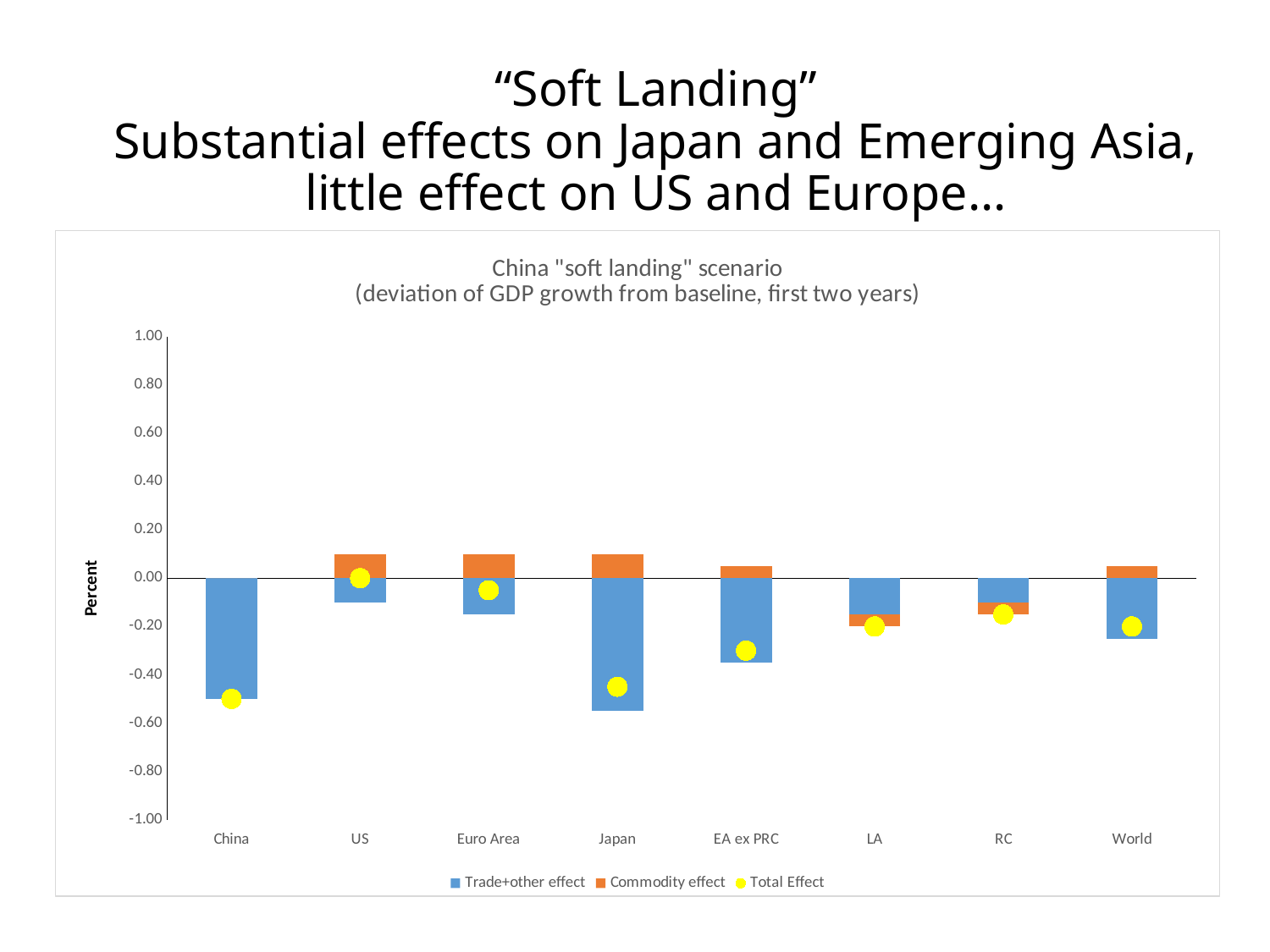
How many series does the chart's legend list? 3 Is the Total Effect value for EA ex PRC greater or less than -0.20? less Is the Commodity effect value for Japan greater or less than 0.00? greater What kind of chart is shown on the slide? bar chart How many countries or regions are shown on the x axis of the chart? 8 Which series in the chart is shown with yellow circle markers? Total Effect What is the title of the chart? China "soft landing" scenario (deviation of GDP growth from baseline, first two years) Is the Trade+other effect value for Japan greater or less than -0.40? less Which has the larger Total Effect value, China or US? US Which has the larger Total Effect value, Japan or Euro Area? Euro Area